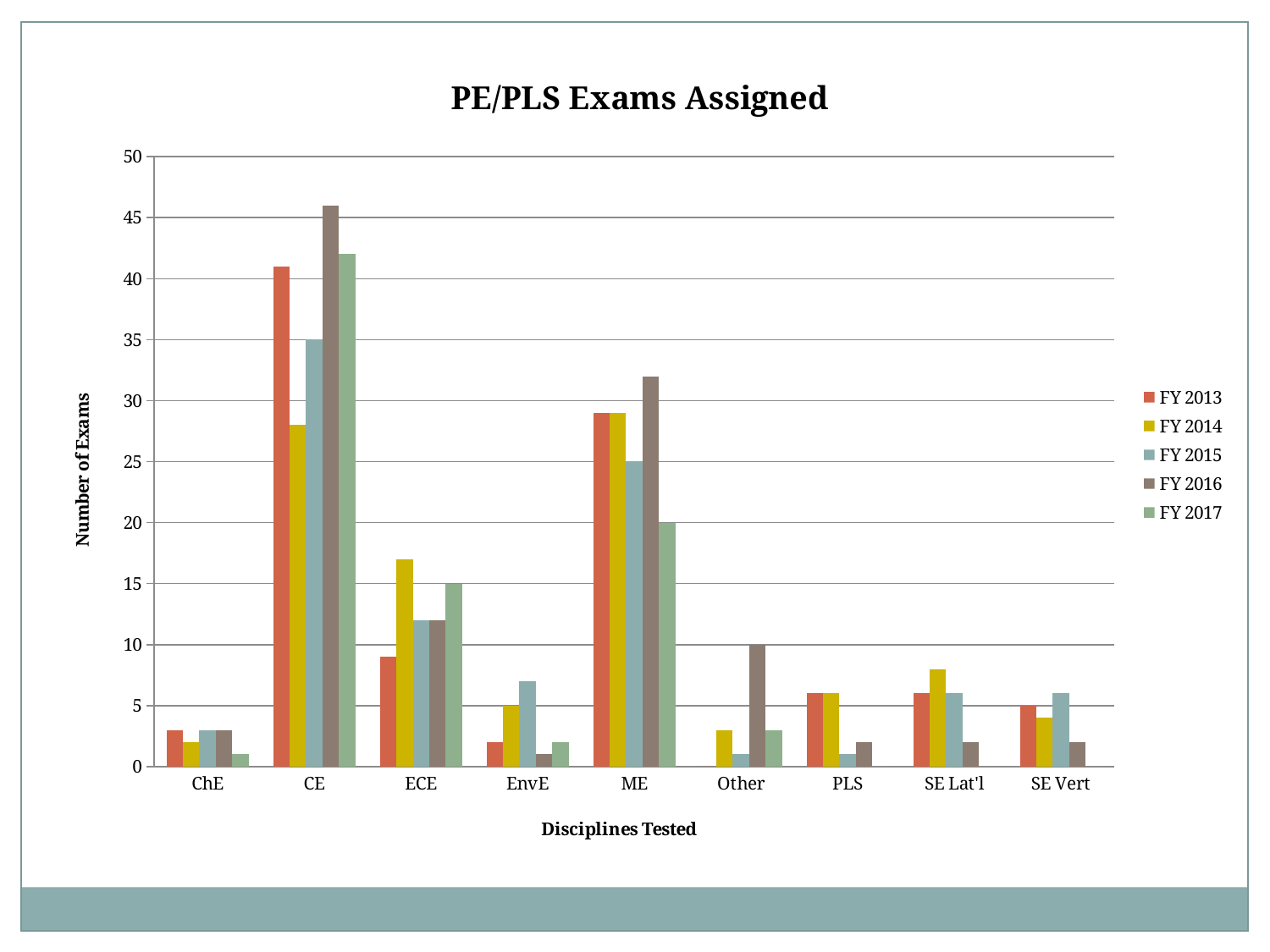
Which is larger for ME: the FY 2015 value or the FY 2017 value? FY 2015 What is the label of the vertical axis? Number of Exams Which discipline has the highest number of exams for FY 2016? CE Which discipline has the highest number of exams for FY 2013? CE How many series does the legend list? 5 Is the FY 2014 value for ECE greater or less than 15? greater How many disciplines are shown along the x axis? 9 Which is larger for CE: the FY 2013 value or the FY 2014 value? FY 2013 Is the FY 2016 value for CE greater or less than 45? greater What is the title of the chart? PE/PLS Exams Assigned What type of chart is shown on the slide? bar chart Is the FY 2016 value for ME greater or less than 30? greater